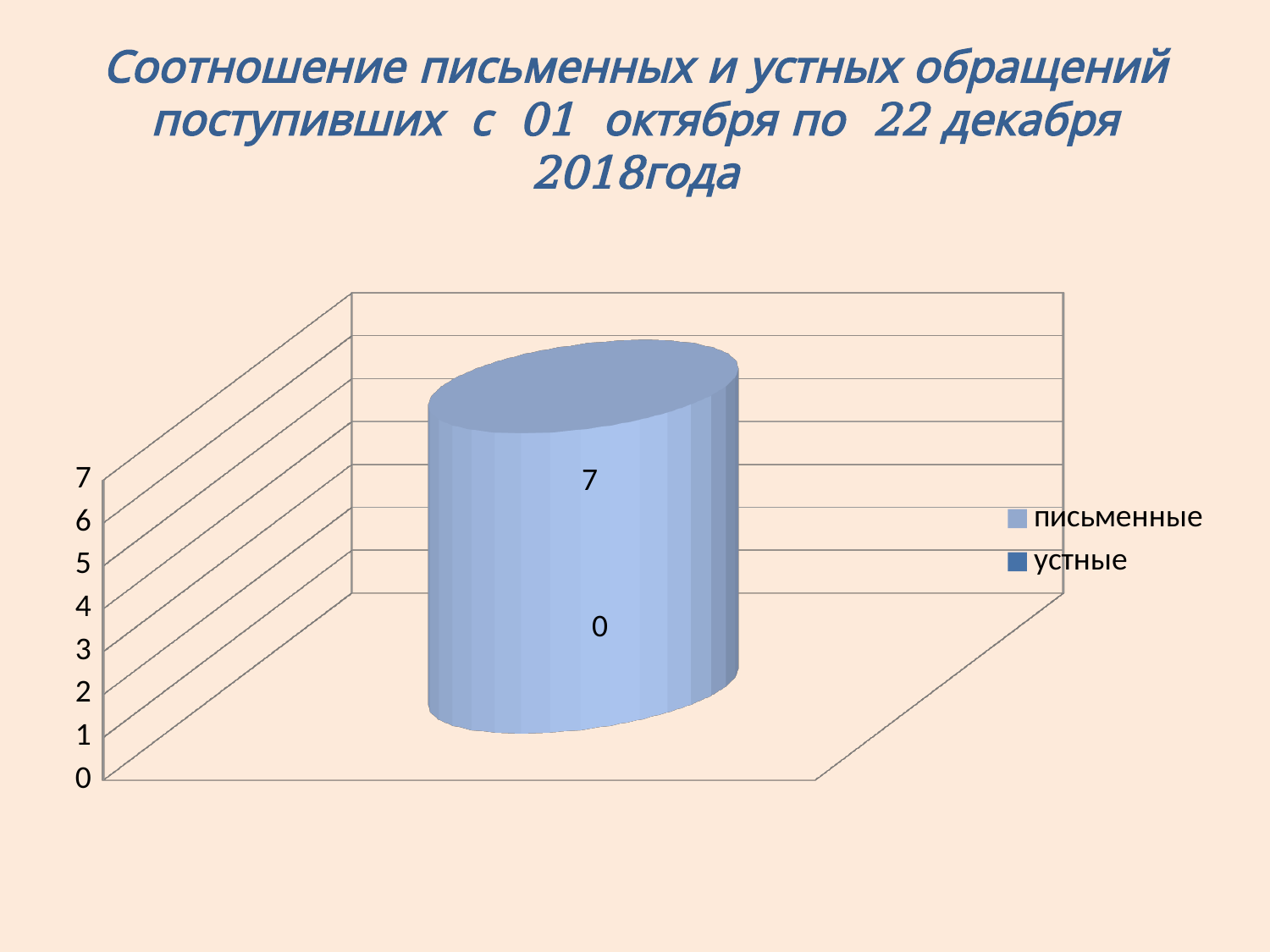
What is the value for письменные? 7 How many series does the legend list? 2 Is the value for письменные greater or less than 5? greater Which series has the higher value, письменные or устные? письменные Which series has the lowest value? устные What is the total of the values for письменные and устные? 7 What is the highest value shown on the vertical axis? 7 What is the difference between the values for письменные and устные? 7 Which legend entry is shown in the lighter blue colour? письменные Which series has the highest value? письменные What is the value for устные? 0 What kind of chart is shown on the slide? bar chart